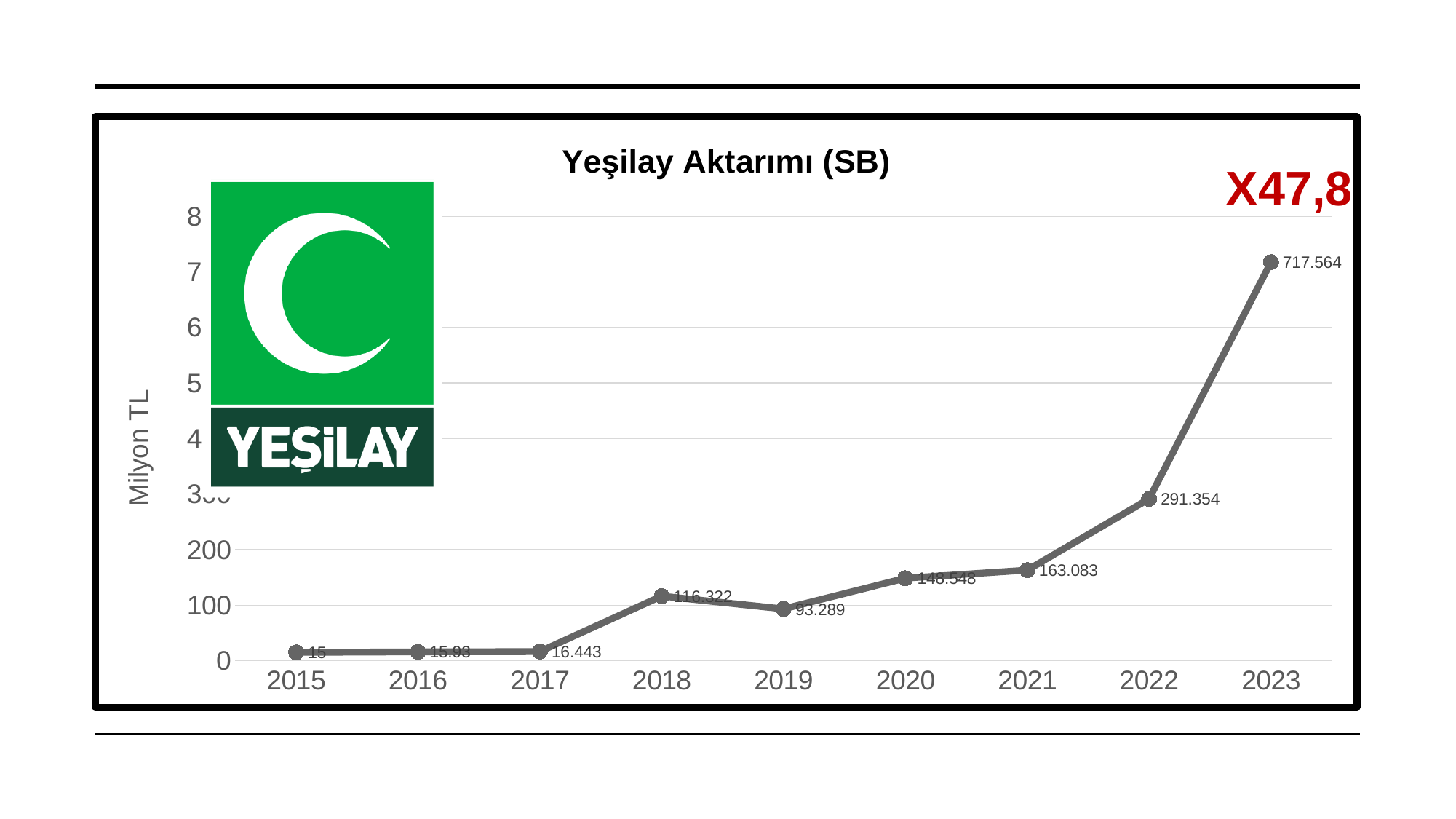
Which year has the lowest value? 2015 What is the difference between the values for 2023 and 2022? 426.21 What is the title of the chart? Yeşilay Aktarımı (SB) How many years are plotted on the x axis? 9 What is the value for 2018? 116.322 What is the difference between the values for 2018 and 2019? 23.033 What is the value for 2016? 15.93 Which year has the highest value? 2023 What is the value for 2023? 717.564 Which is larger, the value for 2019 or the value for 2020? 2020 What type of chart is shown on the slide? line chart What is the label on the y axis? Milyon TL